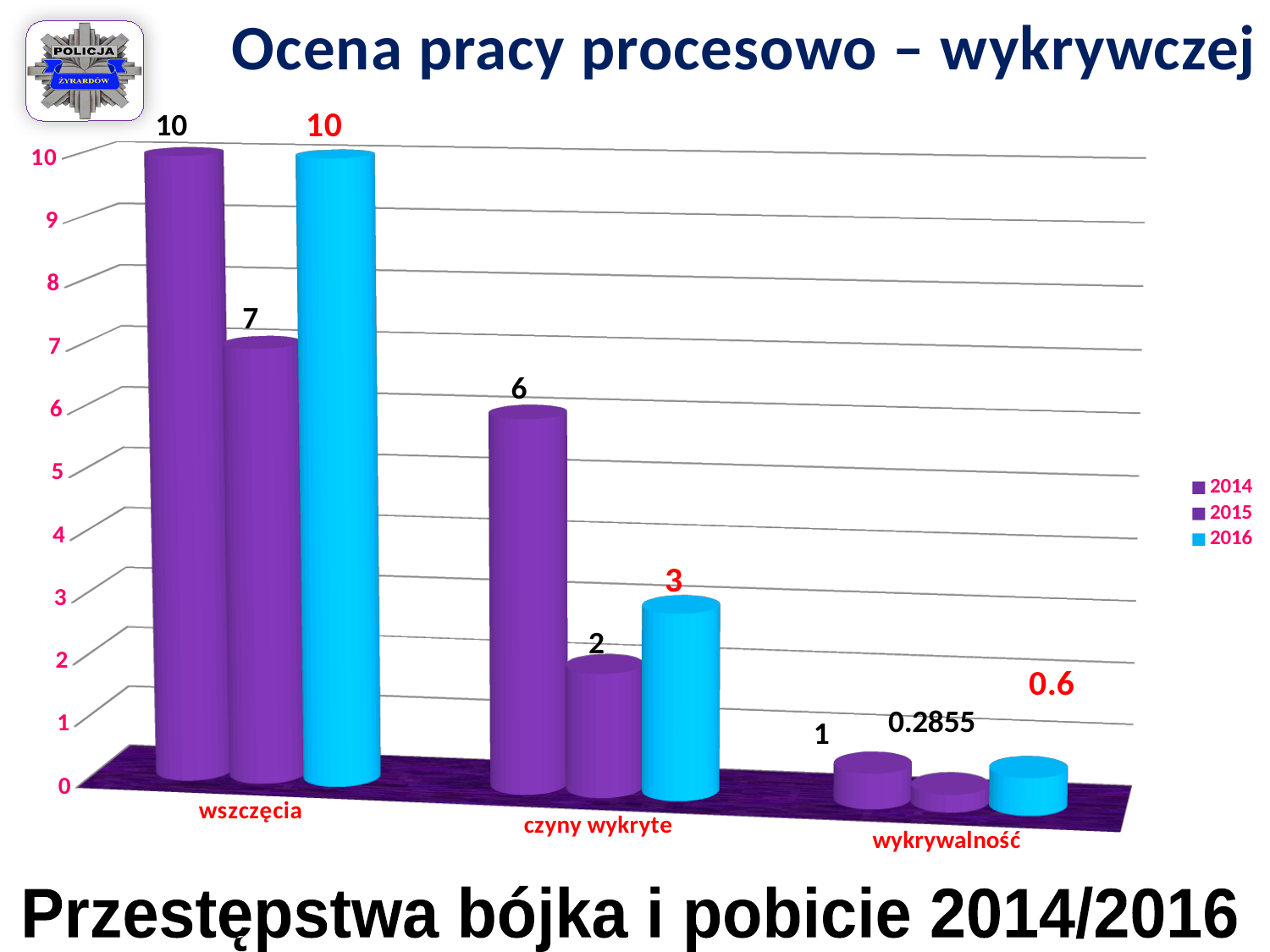
What is the difference between the 2014 and 2016 values in the czyny wykryte category? 3 What is the value for 2015 in the wykrywalność category? 0.2855 Which year has the lowest value in the czyny wykryte category? 2015 Which is larger: the 2016 value for wykrywalność or the 2015 value for wykrywalność? 2016 What kind of chart is shown on the slide? bar chart What is the value for 2014 in the czyny wykryte category? 6 What is the difference between the 2014 and 2015 values in the wszczęcia category? 3 What is the value for 2016 in the czyny wykryte category? 3 How many series does the legend list? 3 How many categories are shown on the x axis? 3 What is the value for 2015 in the wszczęcia category? 7